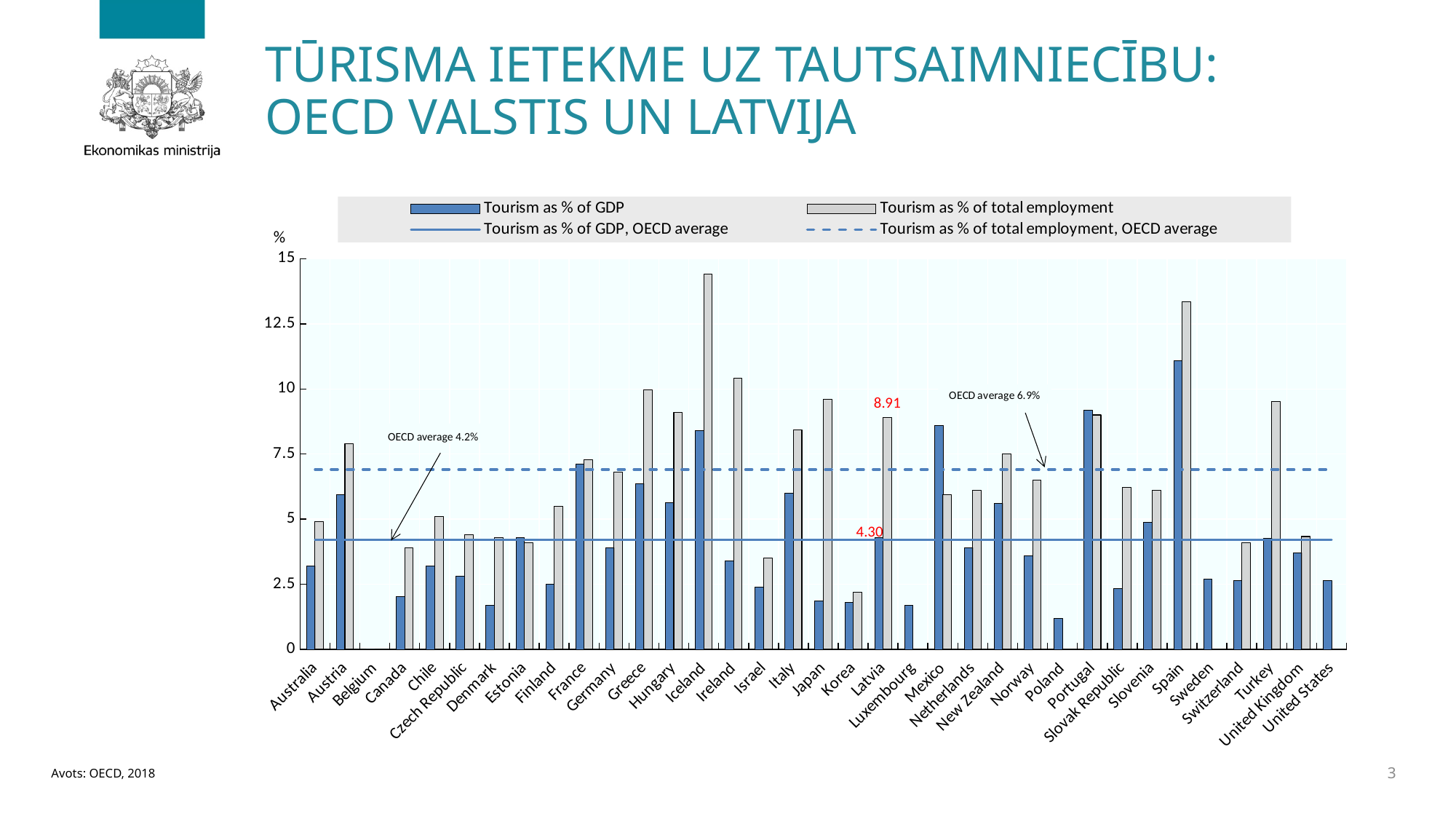
Which country has the highest tourism as % of total employment? Iceland What is the OECD average for tourism as % of total employment shown on the chart? 6.9% What is the value of tourism as % of GDP for Latvia? 4.30 What is the difference between Latvia's tourism as % of total employment and its tourism as % of GDP? 4.61 Which country has the lowest tourism as % of GDP among those with a bar shown? Poland What is the OECD average for tourism as % of GDP shown on the chart? 4.2% What is the value of tourism as % of total employment for Latvia? 8.91 What kind of chart is shown on the slide? Bar chart with horizontal lines for the OECD averages (combination bar and line chart) How many series does the legend list? 4 Which country has the highest tourism as % of GDP? Spain Is the tourism as % of GDP value for Spain greater or less than 10? greater Which is larger for Latvia: tourism as % of GDP or tourism as % of total employment? Tourism as % of total employment